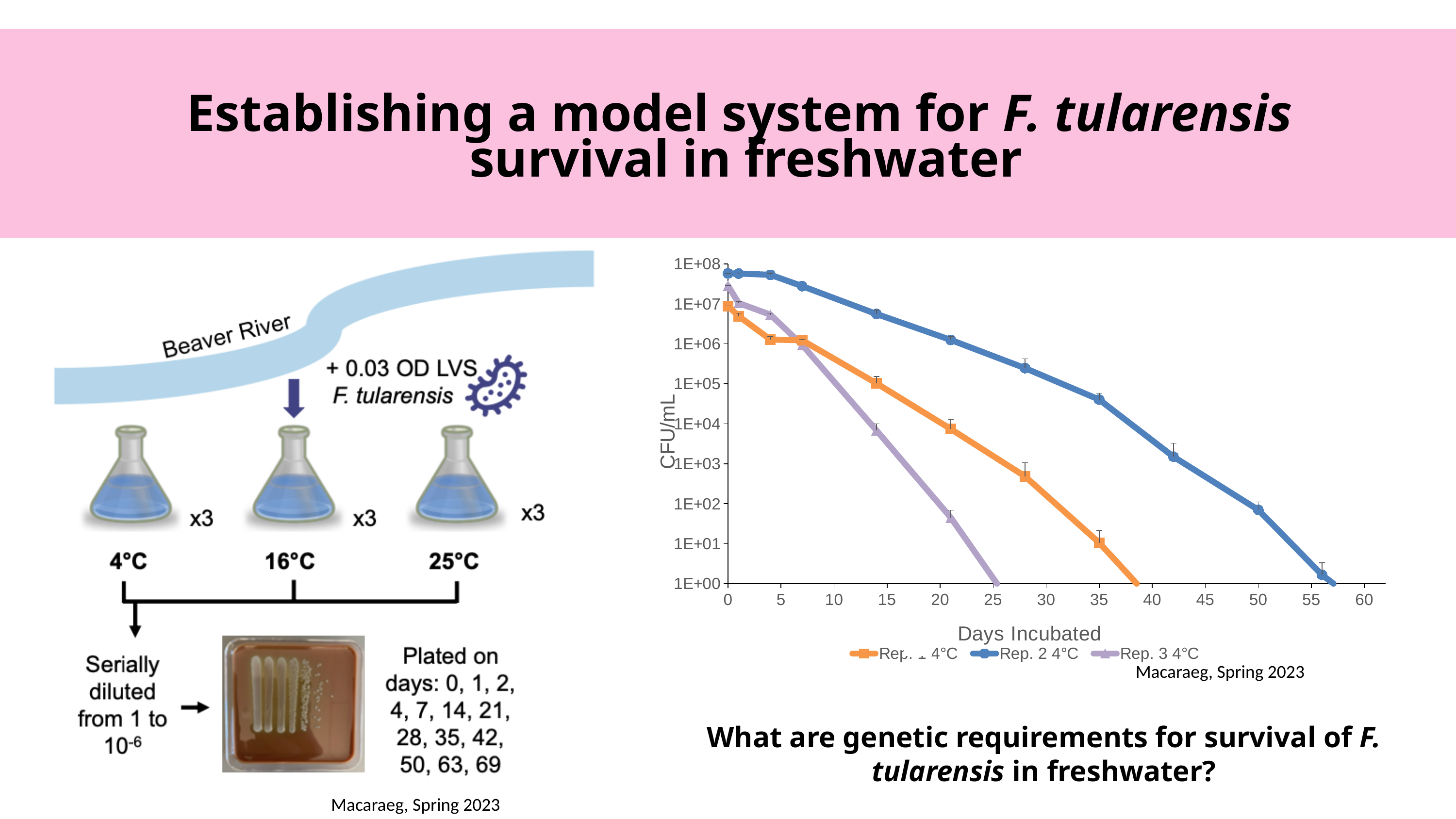
What kind of chart is shown on the right side of the slide? line chart Which series in the line chart reaches 1E+00 CFU/mL at the latest day? Rep. 2 4°C What is the title of the x axis of the line chart? Days Incubated Is the value for Rep. 1 4°C at day 28 greater or less than 1E+03? less What is the title of the y axis of the line chart? CFU/mL Is the value for Rep. 3 4°C at day 21 greater or less than 1E+02? less Do the CFU/mL values for Rep. 2 4°C rise or fall as the days incubated increase? fall At day 21, which series has the higher CFU/mL, Rep. 1 4°C or Rep. 2 4°C? Rep. 2 4°C At day 14, which series has the higher CFU/mL, Rep. 1 4°C or Rep. 3 4°C? Rep. 1 4°C Is the value for Rep. 2 4°C at day 14 greater or less than 1E+07? less How many series does the legend of the CFU/mL chart list? 3